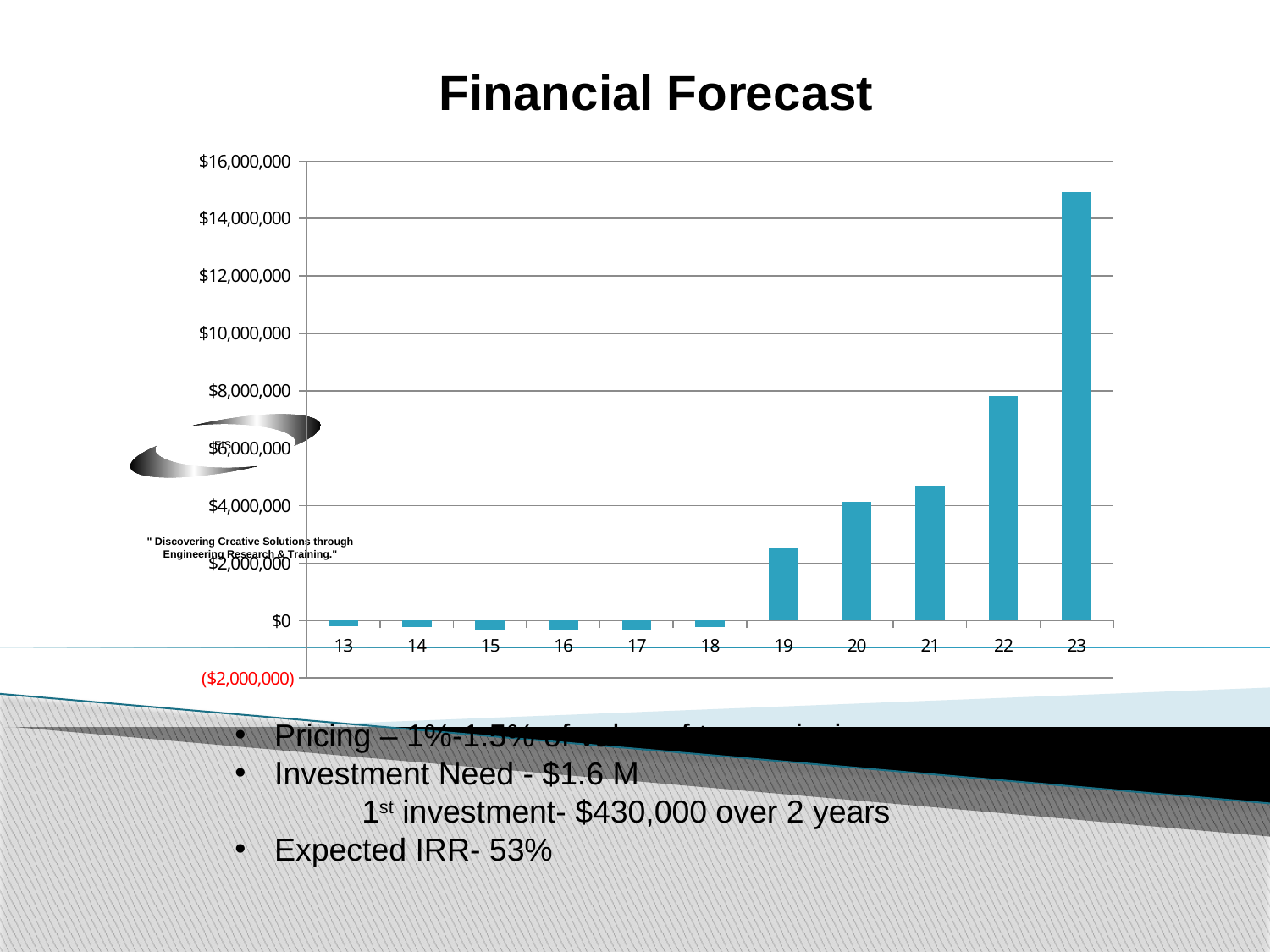
Do the values rise or fall from 19 to 23? rise Which is larger, the value for 20 or the value for 21? 21 Is the value for 21 greater or less than $6,000,000? less How many categories are shown on the x axis of the chart? 11 Which is larger, the value for 22 or the value for 23? 23 Is the value for 23 greater or less than $14,000,000? greater Which category has the highest value in the chart? 23 What is the title of the slide containing the chart? Financial Forecast What kind of chart is shown on the slide? bar chart Is the value for 22 greater or less than $6,000,000? greater